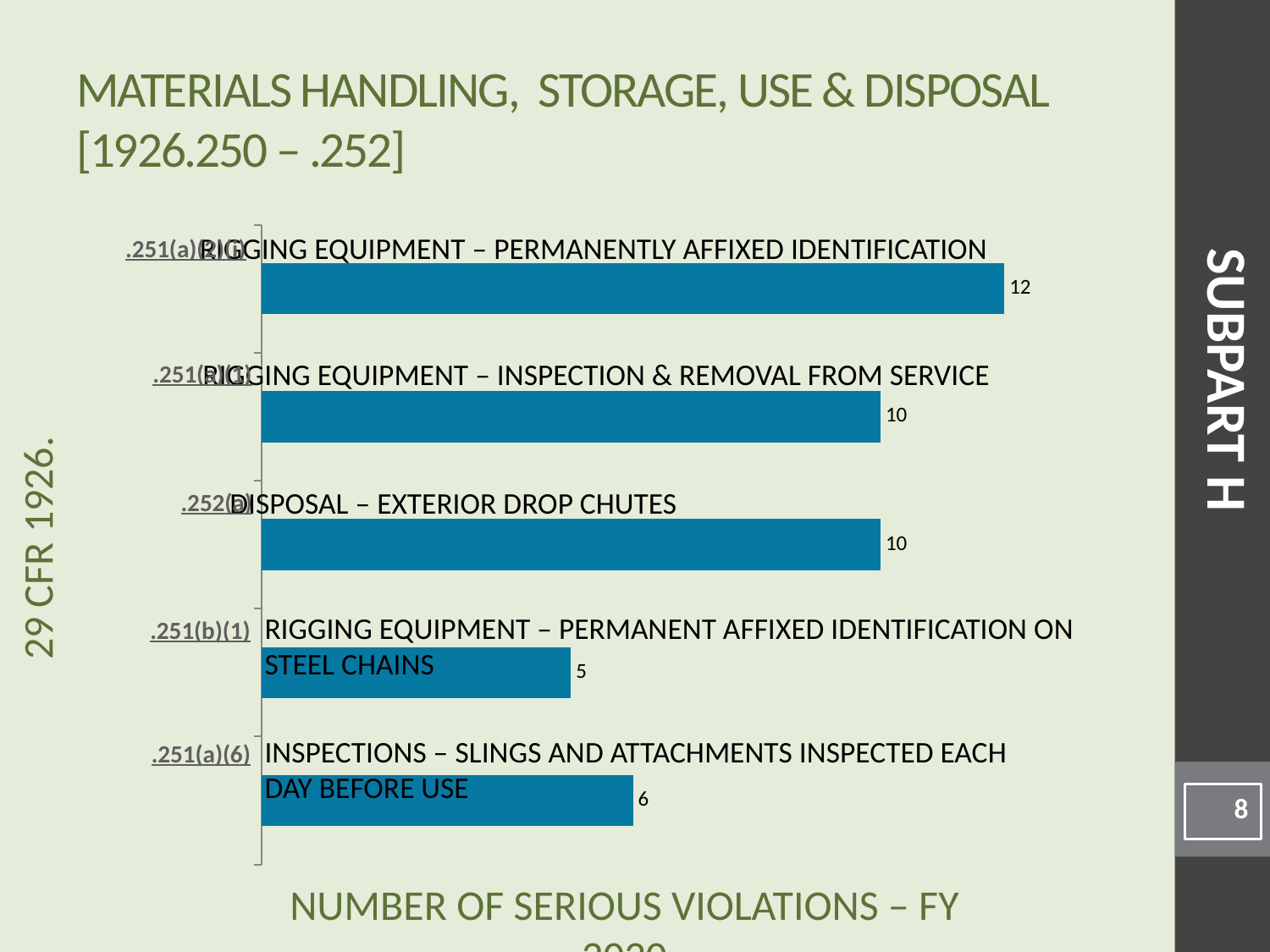
What is the value for Inspections – Slings and Attachments Inspected Each Day Before Use? 6 Which category has the lowest number of serious violations? Rigging Equipment – Permanent Affixed Identification on Steel Chains What kind of chart is shown on the slide? Bar chart How many categories are plotted in the chart? 5 How many serious violations are shown for Disposal – Exterior Drop Chutes? 10 What is the value for Rigging Equipment – Permanent Affixed Identification on Steel Chains (.251(b)(1))? 5 What is the difference between the values for Rigging Equipment – Permanently Affixed Identification and Rigging Equipment – Inspection & Removal from Service? 2 Which is larger: the value for Inspections – Slings and Attachments Inspected Each Day Before Use or the value for Rigging Equipment – Permanent Affixed Identification on Steel Chains? Inspections – Slings and Attachments Inspected Each Day Before Use What colour are the bars in the chart? Blue What is the difference between the values for Disposal – Exterior Drop Chutes and Rigging Equipment – Permanent Affixed Identification on Steel Chains? 5 What is the value for Rigging Equipment – Permanently Affixed Identification? 12 Which category has the highest number of serious violations? Rigging Equipment – Permanently Affixed Identification